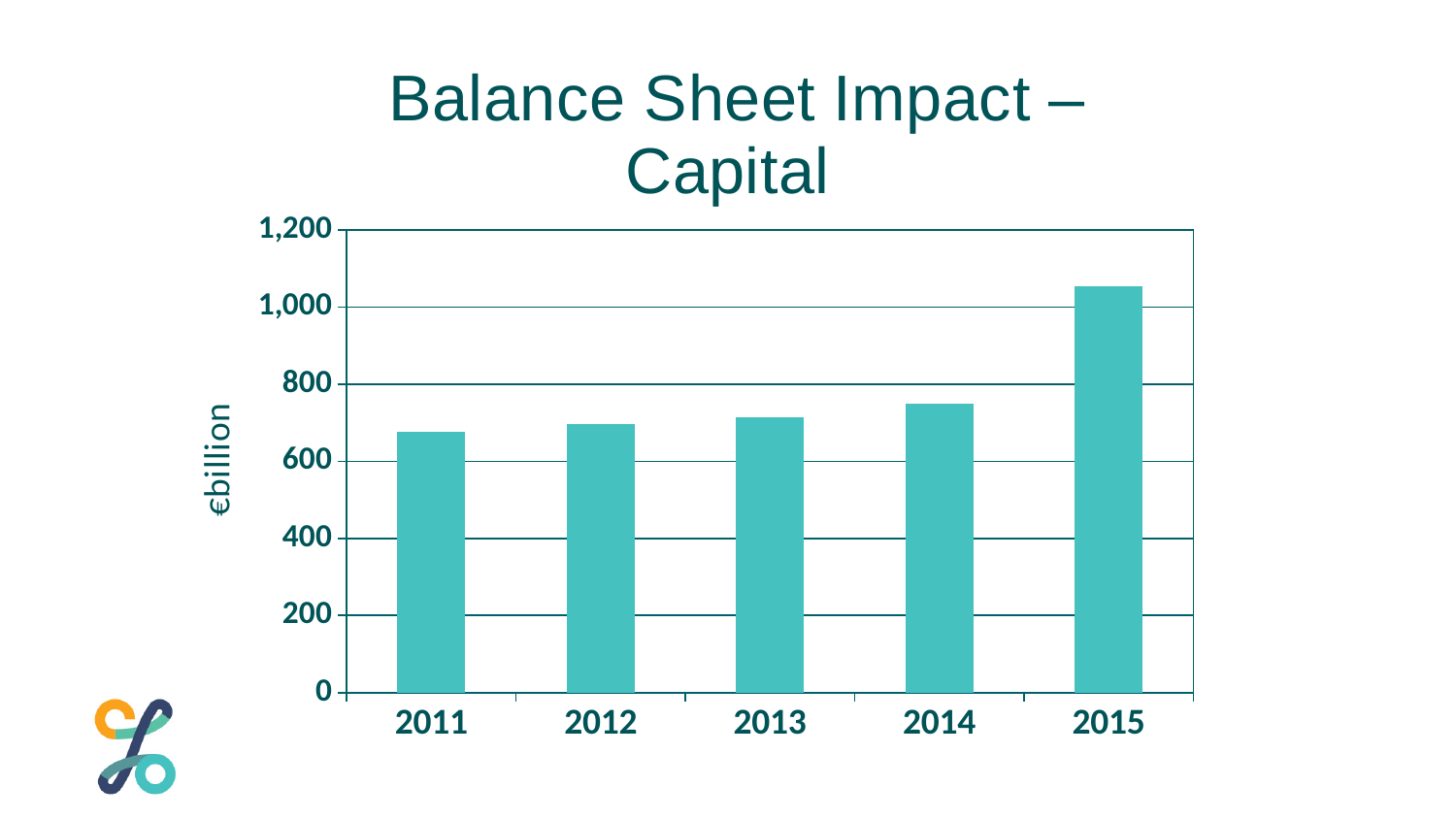
What kind of chart is shown on the slide? bar chart Which year has the highest value on the chart? 2015 Which is larger, the value for 2014 or the value for 2015? 2015 Do the values rise or fall from 2011 to 2015? rise Is the value for 2014 greater or less than 800? less Is the value for 2013 greater or less than 600? greater Is the value for 2011 greater or less than 800? less What is the label on the vertical axis? €billion How many years are plotted on the chart? 5 What is the title of the chart? Balance Sheet Impact – Capital